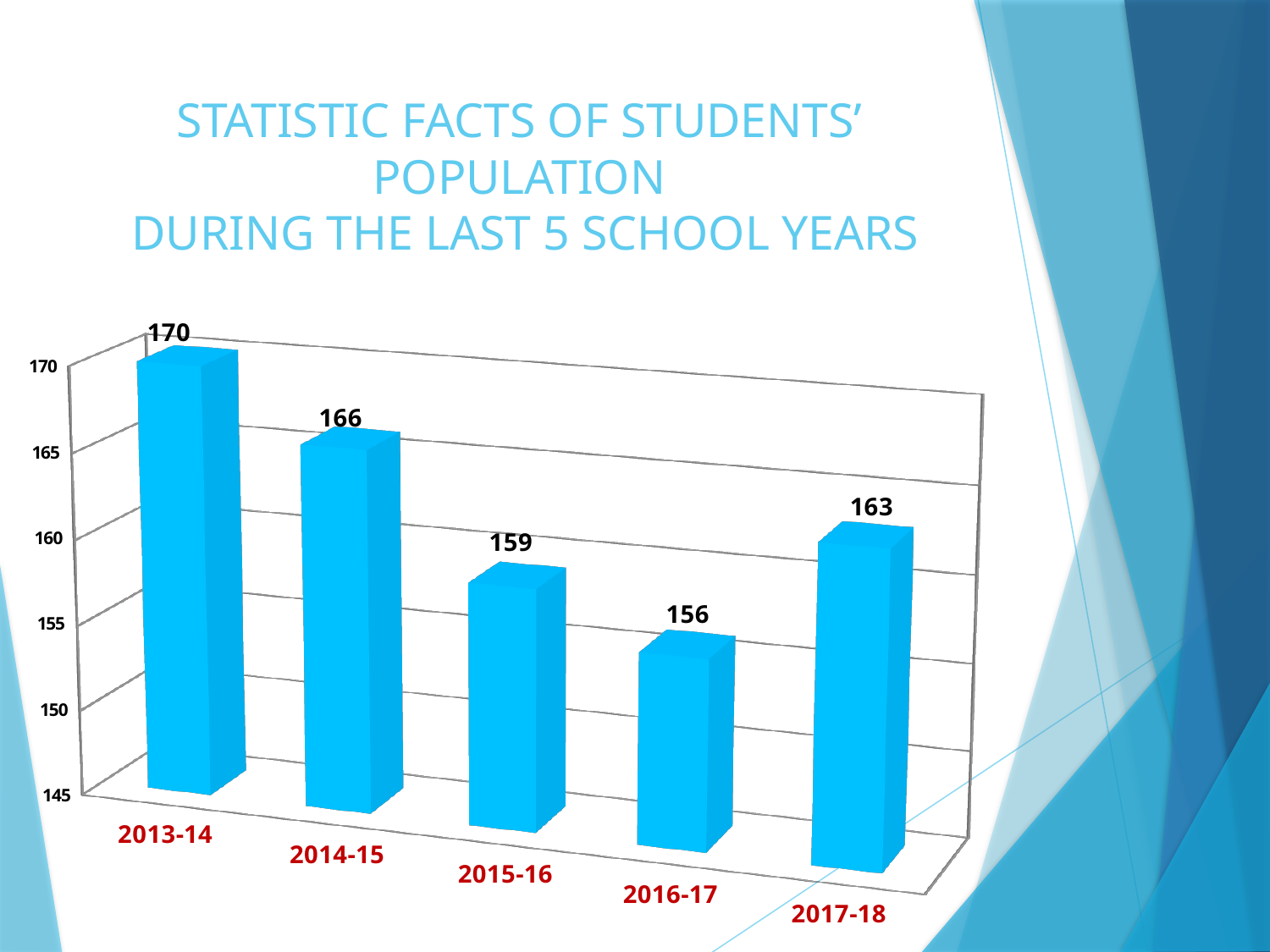
Does the student population rise or fall from 2013-14 to 2016-17? fall What is the student population for 2017-18? 163 What is the difference between the student population in 2013-14 and 2016-17? 14 Is the value for 2014-15 greater or less than 160? greater What is the difference between the student population in 2014-15 and 2015-16? 7 How many school years are shown in the chart? 5 What is the student population for 2013-14? 170 What kind of chart is shown on the slide? bar chart Which school year has the highest student population? 2013-14 What is the student population for 2016-17? 156 Which is larger, the student population in 2015-16 or in 2017-18? 2017-18 Which school year has the lowest student population? 2016-17